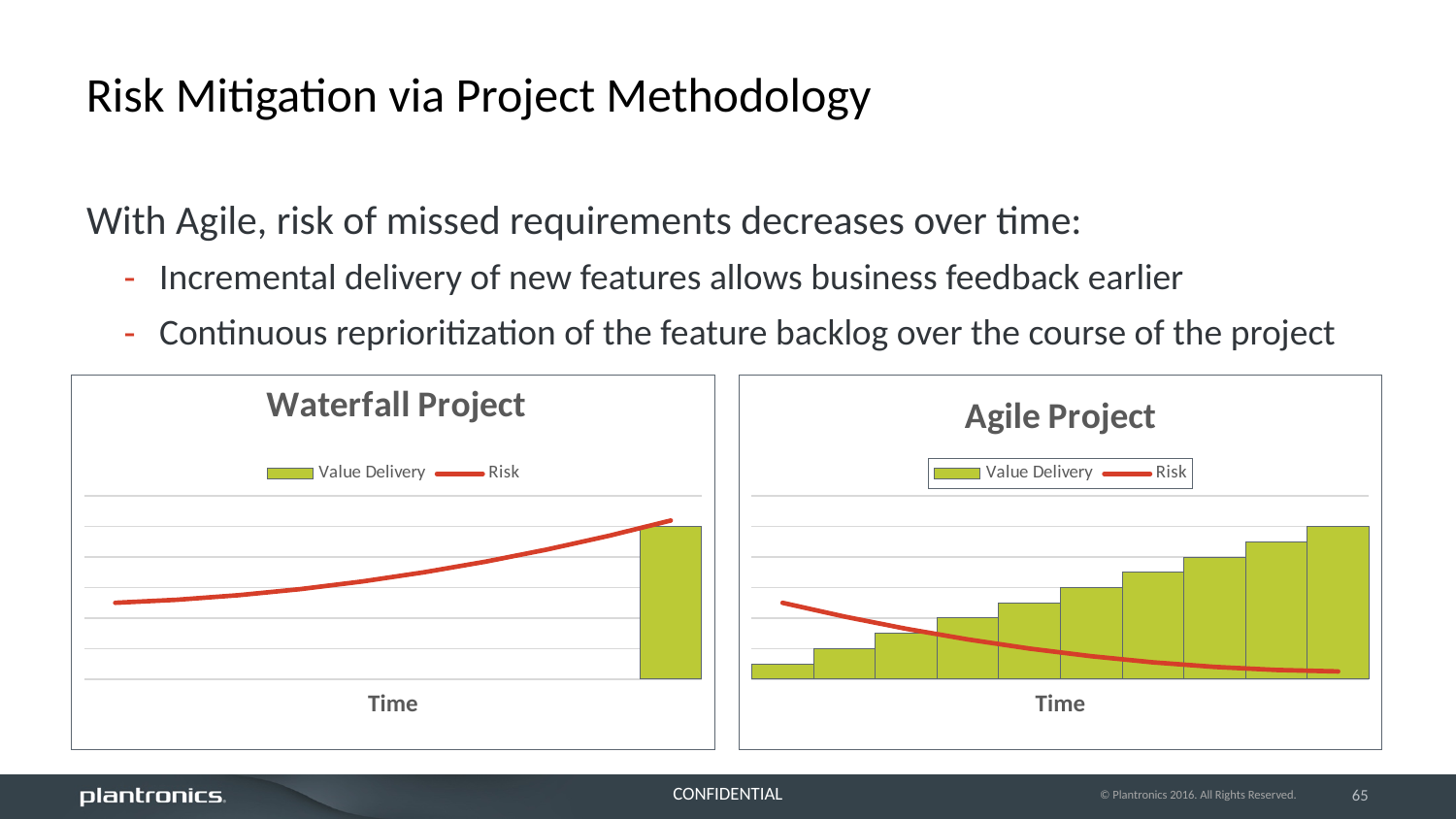
In the Agile Project chart, is the Risk line higher at the start or at the end of the Time axis? At the start In the Waterfall Project chart, does the Risk line rise or fall along the Time axis? Rises In the Agile Project chart, which Value Delivery bar is the tallest? The rightmost (last) bar In the Agile Project chart, do the Value Delivery bars rise or fall along the Time axis? Rise In the Agile Project chart, does the Risk line rise or fall along the Time axis? Falls In the Waterfall Project chart, how many bars are plotted for Value Delivery? 1 Which series is shown as a red line in the Agile Project chart? Risk In the Agile Project chart, which Value Delivery bar is the shortest? The leftmost (first) bar How many series does the legend of the Agile Project chart list? 2 What kind of chart is the Waterfall Project chart? A combination of a bar chart and a line chart What is the x-axis title of the Waterfall Project chart? Time In the Agile Project chart, how many bars are plotted for Value Delivery? 10